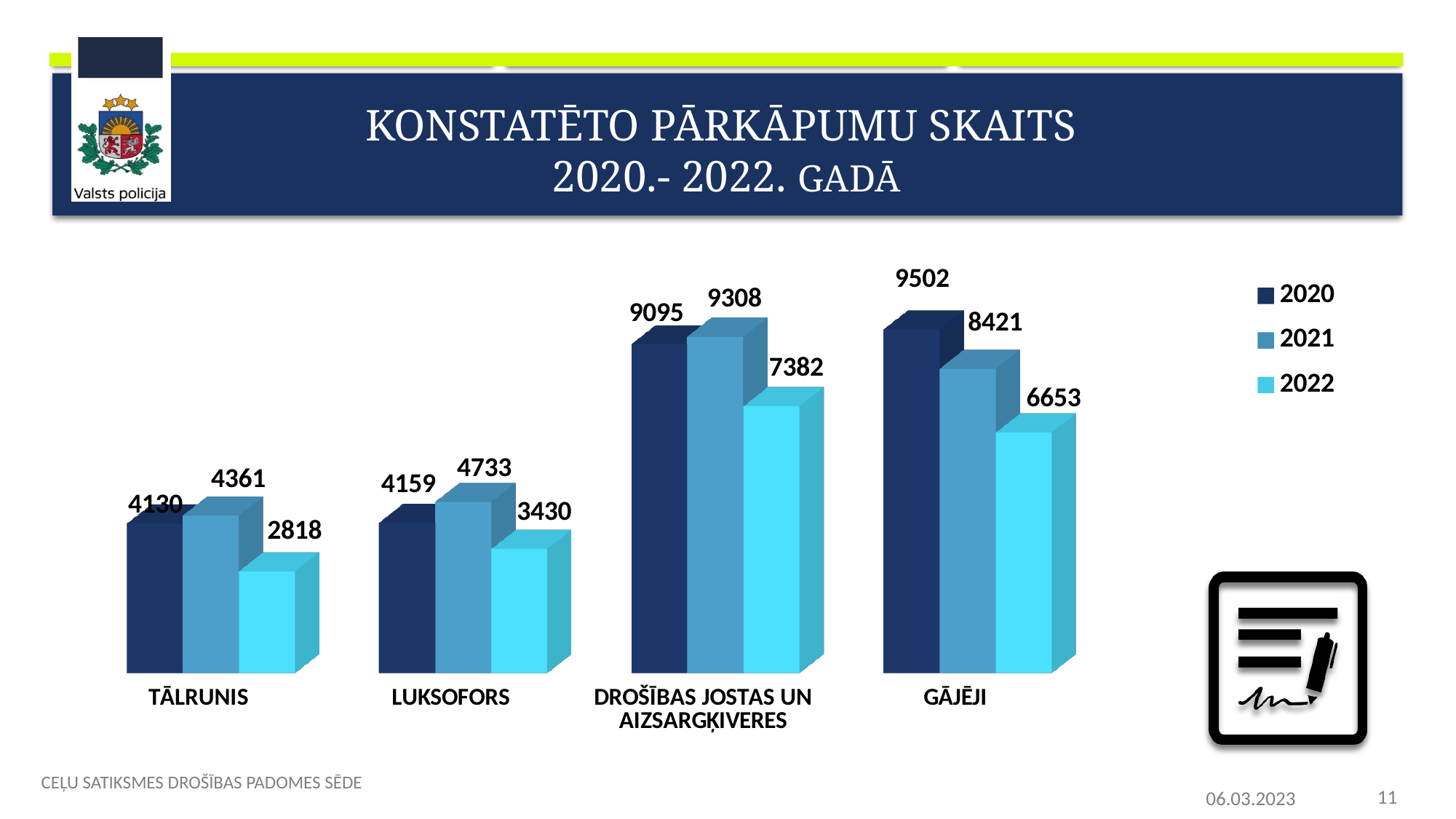
How many categories are shown on the x axis? 4 What is the value for GĀJĒJI in 2020? 9502 Which years are listed in the legend? 2020, 2021, 2022 What is the value for DROŠĪBAS JOSTAS UN AIZSARGĶIVERES in 2022? 7382 Which category has the lowest value in 2022? TĀLRUNIS What kind of chart is shown on the slide? bar chart What is the value for TĀLRUNIS in 2022? 2818 How many series does the legend list? 3 Which is larger for DROŠĪBAS JOSTAS UN AIZSARGĶIVERES: the 2020 value or the 2021 value? 2021 What is the value for LUKSOFORS in 2021? 4733 What is the difference between the 2021 and 2022 values for GĀJĒJI? 1768 Which category has the highest value in 2020? GĀJĒJI